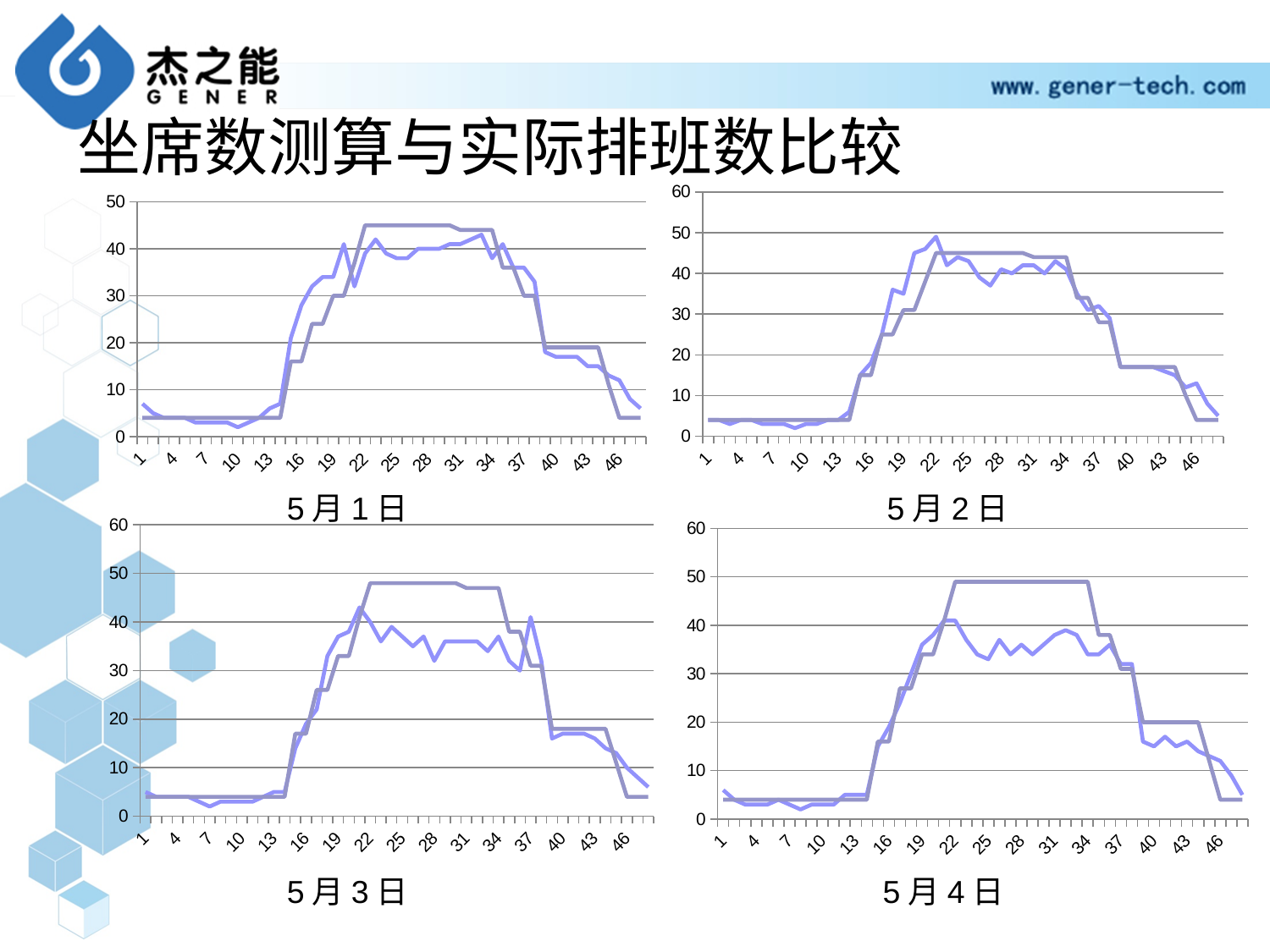
What is the title of the slide? 坐席数测算与实际排班数比较 In the 5月4日 chart, how many lines are plotted? 2 How many charts are shown on the slide? 4 In the 5月4日 chart, is the value of the flat-topped line at x = 43 greater or less than 30? less What is the highest value shown on the y axis of the 5月1日 chart? 50 In the 5月3日 chart, do the values rise or fall between x = 13 and x = 22? rise In the 5月3日 chart, is the value of the flat-topped line at x = 28 greater or less than 40? greater In the 5月2日 chart, do the values rise or fall between x = 34 and x = 46? fall In the 5月4日 chart, is the value of the flat-topped line at x = 25 greater or less than the value at x = 40? greater In the 5月2日 chart, is the value at x = 1 greater or less than 10? less What kind of chart is the 5月1日 chart? line chart